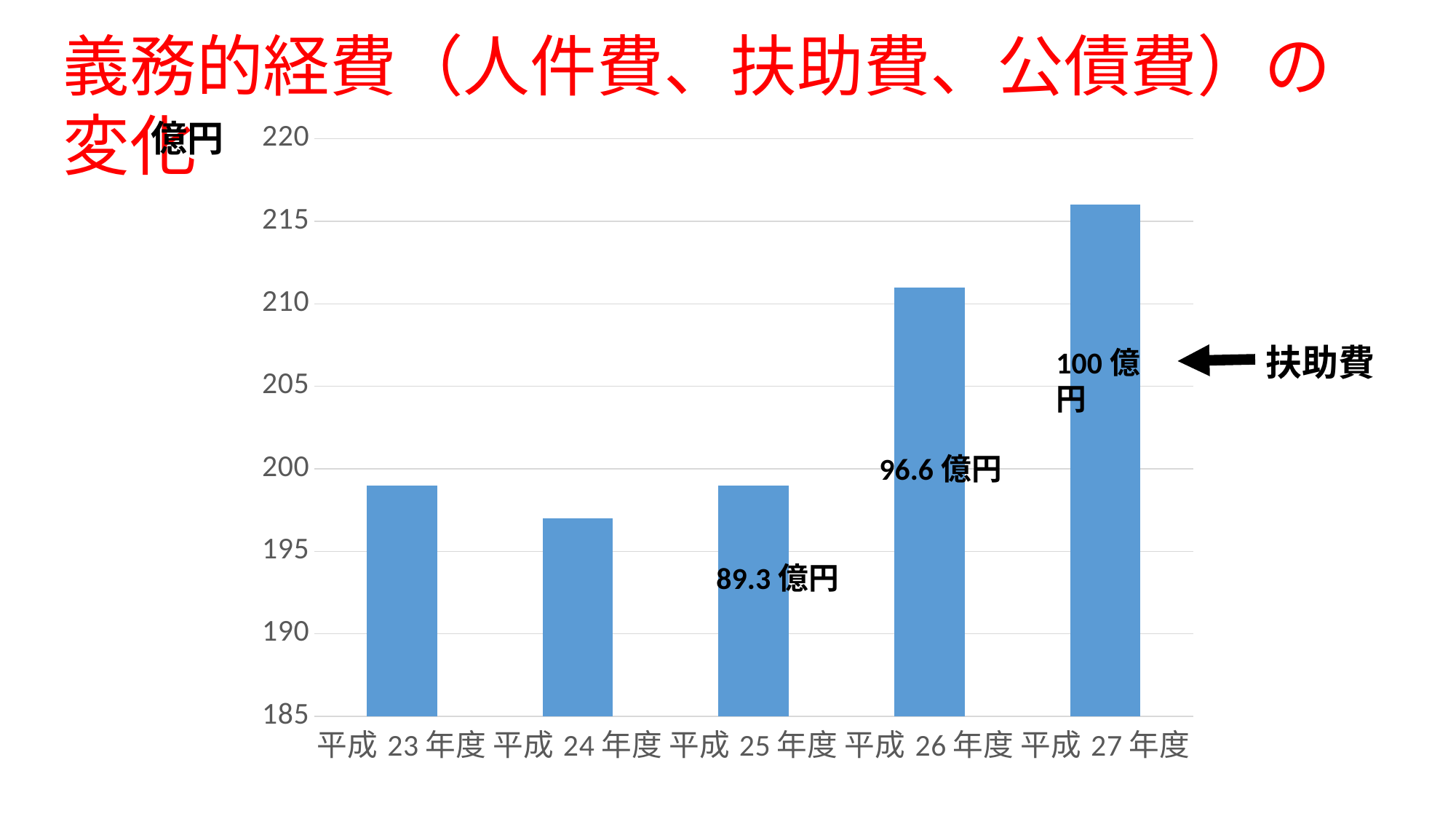
Which fiscal year has the highest bar? 平成27年度 Is the value for 平成24年度 greater or less than 200? less What label is attached to the arrow pointing at the 平成27年度 bar? 扶助費 What type of chart is shown on the slide? bar chart Is the value for 平成23年度 greater or less than 200? less What unit is written at the top of the vertical axis? 億円 Which is larger, the value for 平成26年度 or the value for 平成24年度? 平成26年度 Is the value for 平成27年度 greater or less than 210? greater Do the values rise or fall from 平成24年度 to 平成27年度? rise Which fiscal year has the lowest bar? 平成24年度 How many fiscal years (categories) are plotted on the x axis? 5